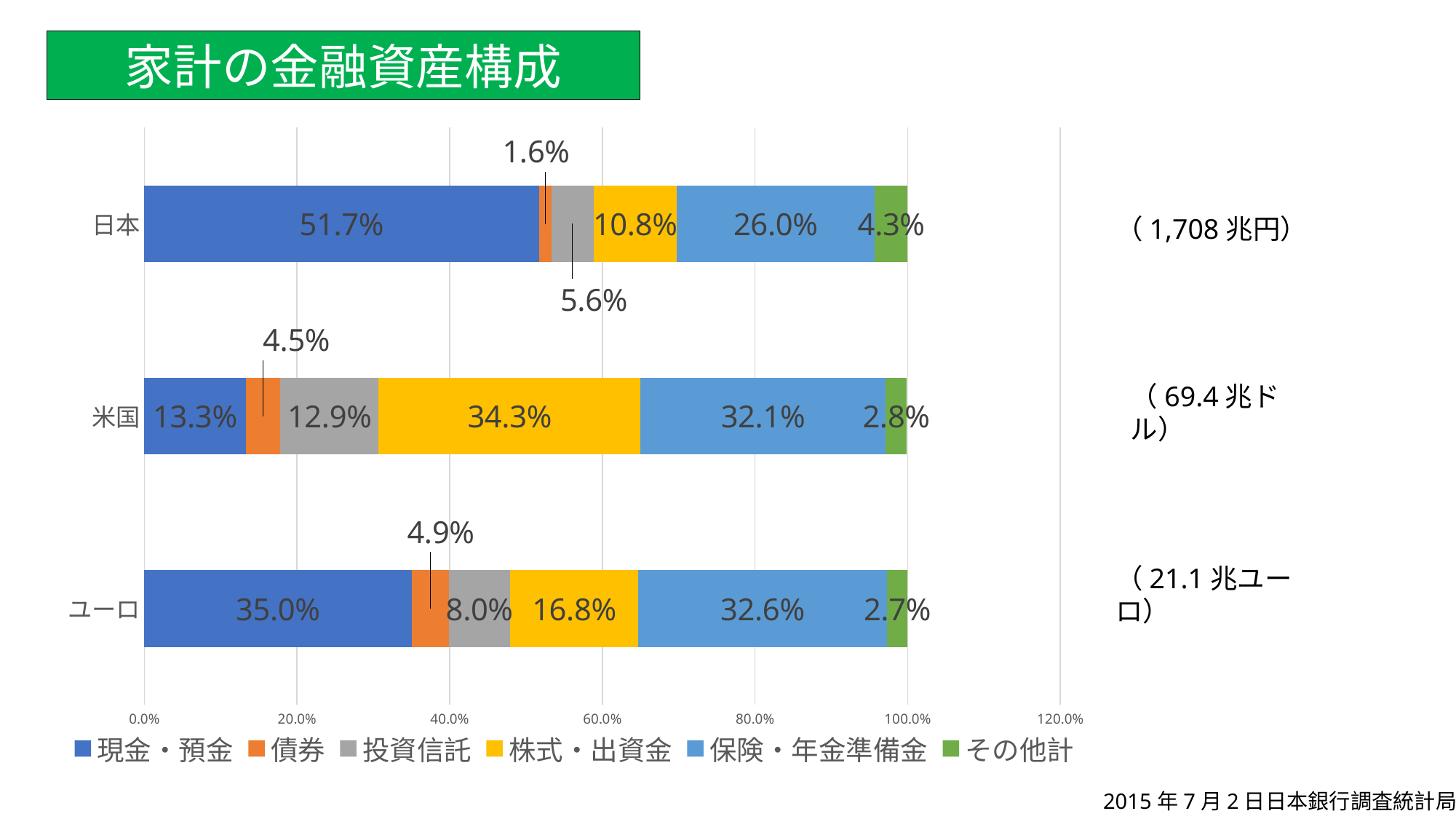
What is the title of the slide? 家計の金融資産構成 What is the value for 現金・預金 in the 日本 bar? 51.7% How many series does the legend list? 6 What is the value for 株式・出資金 in the 米国 bar? 34.3% What is the difference between the 現金・預金 values for 日本 and 米国? 38.4% What is the value for 債券 in the 日本 bar? 1.6% Which category has the lowest value for 株式・出資金? 日本 Which is larger, the 投資信託 value for 米国 or for ユーロ? 米国 Which category has the highest value for 現金・預金? 日本 How many categories are shown on the chart? 3 What is the value for 保険・年金準備金 in the ユーロ bar? 32.6% What kind of chart is shown on the slide? Stacked bar chart